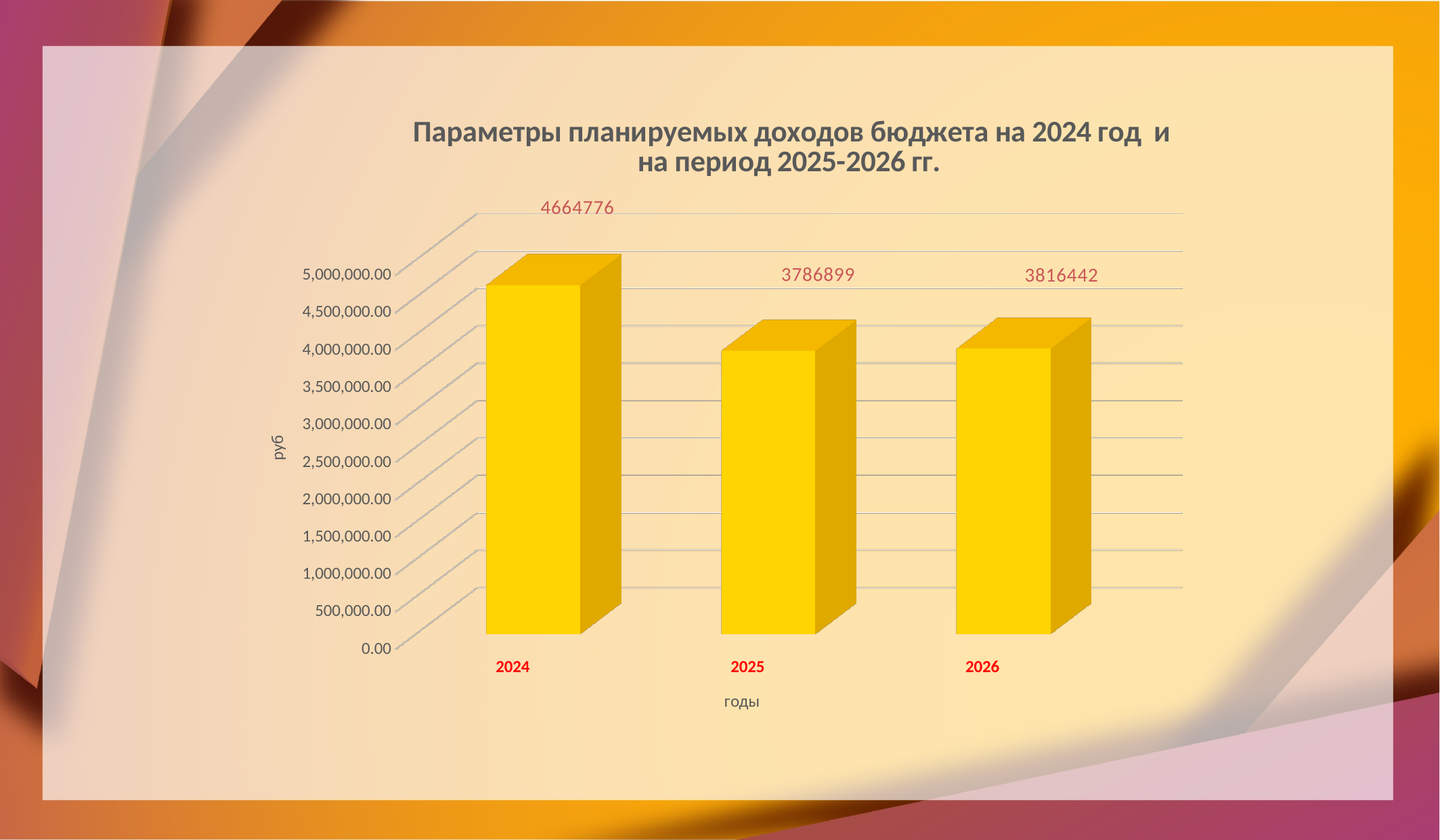
Which is larger, the value for 2025 or the value for 2026? 2026 What is the difference between the values for 2024 and 2025? 877877 Which year has the lowest value? 2025 Which year has the highest value? 2024 What kind of chart is shown on the slide? bar chart How many years are shown on the x axis? 3 Is the value for 2024 greater or less than 4,500,000.00? greater What is the label of the vertical axis? руб What is the difference between the values for 2026 and 2025? 29543 What is the value for 2024? 4664776 What is the value for 2026? 3816442 What is the value for 2025? 3786899